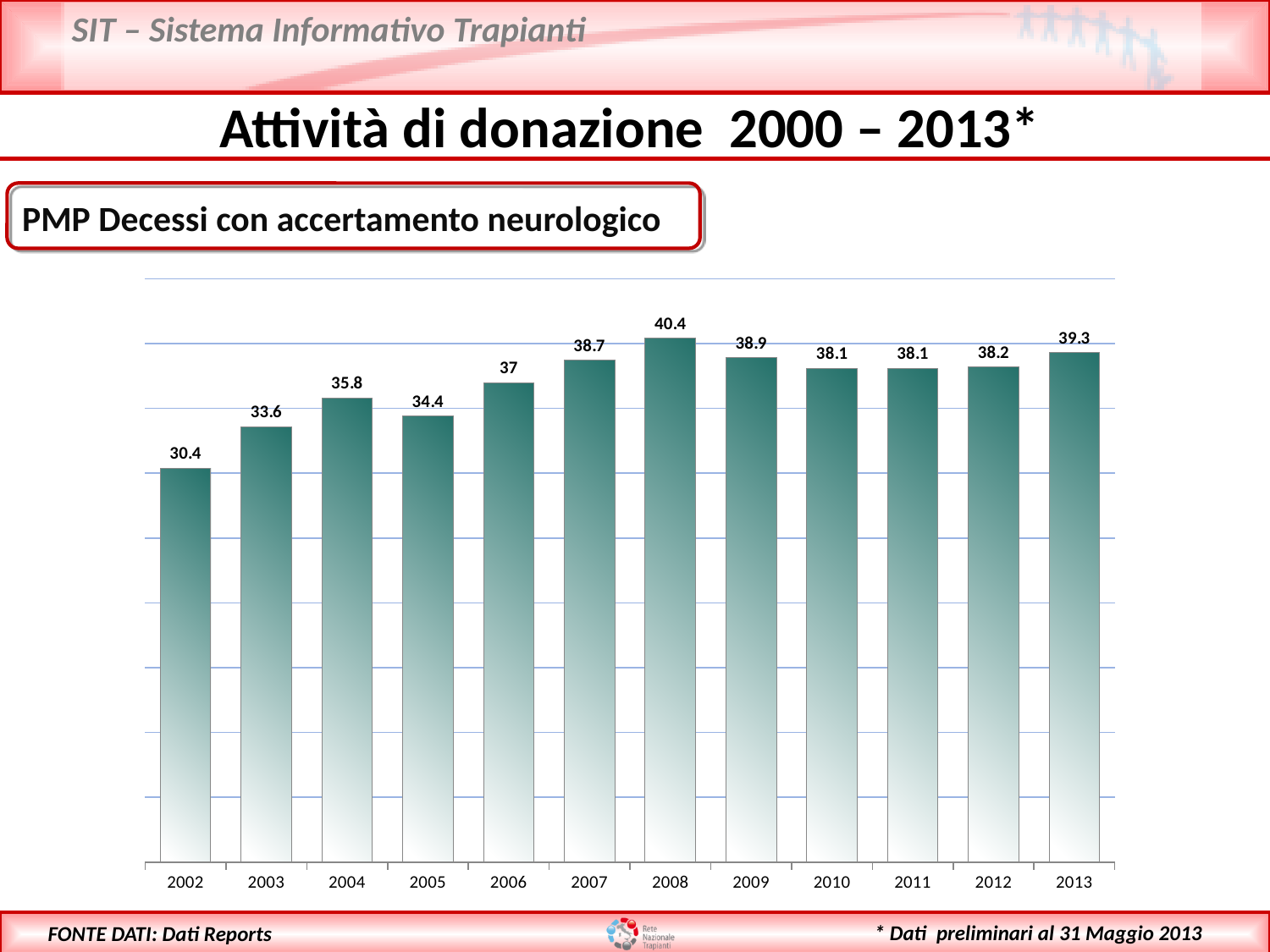
What is the value for 2013? 39.3 What kind of chart is this? bar chart What is the difference between the values for 2008 and 2002? 10 What is the value for 2008? 40.4 What is the value for 2002? 30.4 Which year has the highest value? 2008 What is the difference between the values for 2013 and 2012? 1.1 Do the values generally rise or fall from 2002 to 2008? rise What is the value for 2006? 37 Which is larger, the value for 2004 or the value for 2005? 2004 How many years are shown on the x axis? 12 Which year has the lowest value? 2002